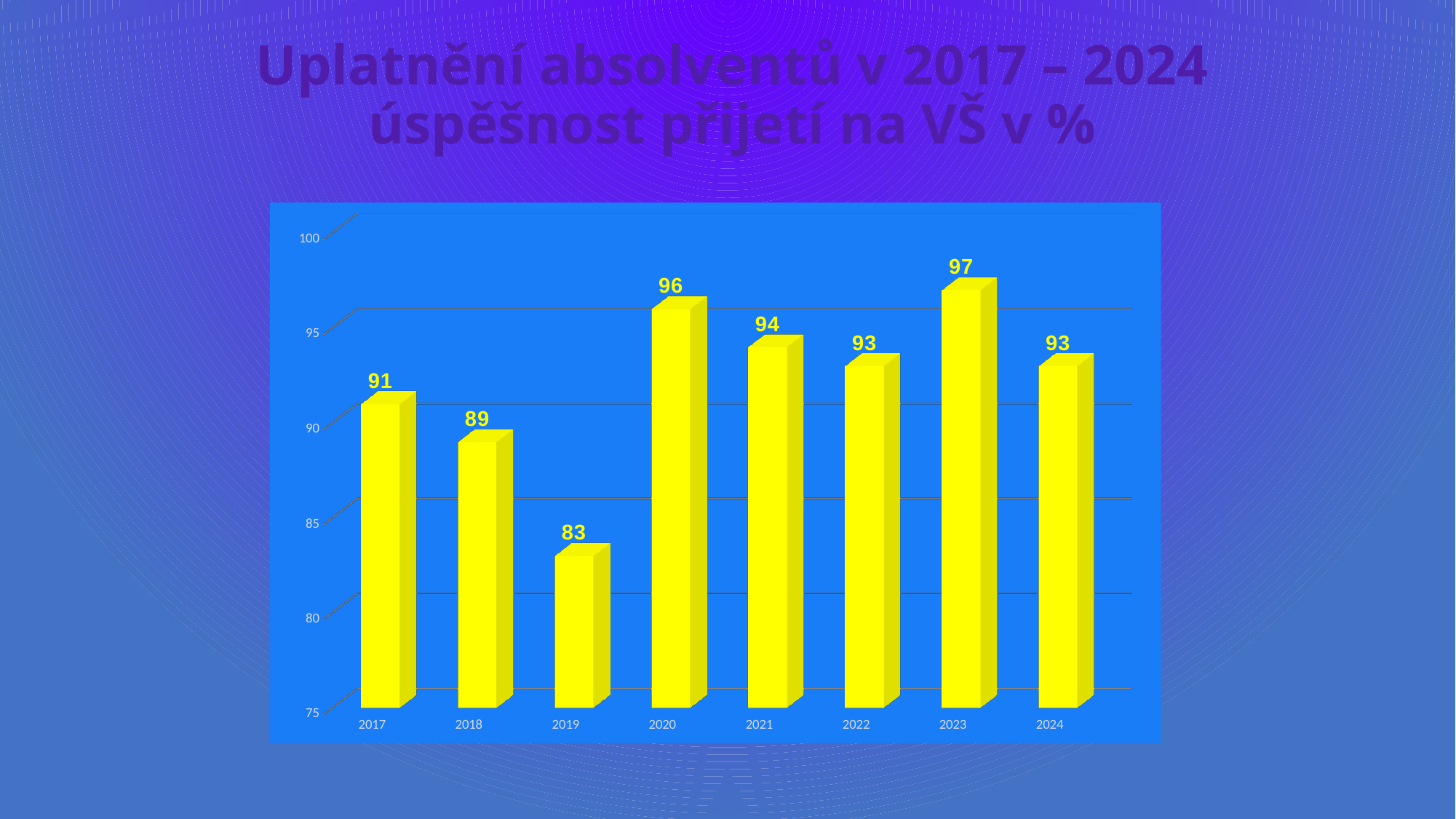
Which year has the lowest value? 2019 What kind of chart is shown on the slide? bar chart What is the value for 2023? 97 What colour are the bars in the chart? yellow Which year has the highest value? 2023 What is the value for 2019? 83 Which is larger, the value for 2018 or the value for 2021? 2021 Do the values rise or fall from 2017 to 2019? fall What is the value for 2017? 91 Is the value for 2022 greater or less than 90? greater What is the difference between the values for 2020 and 2019? 13 How many years are shown on the x axis? 8